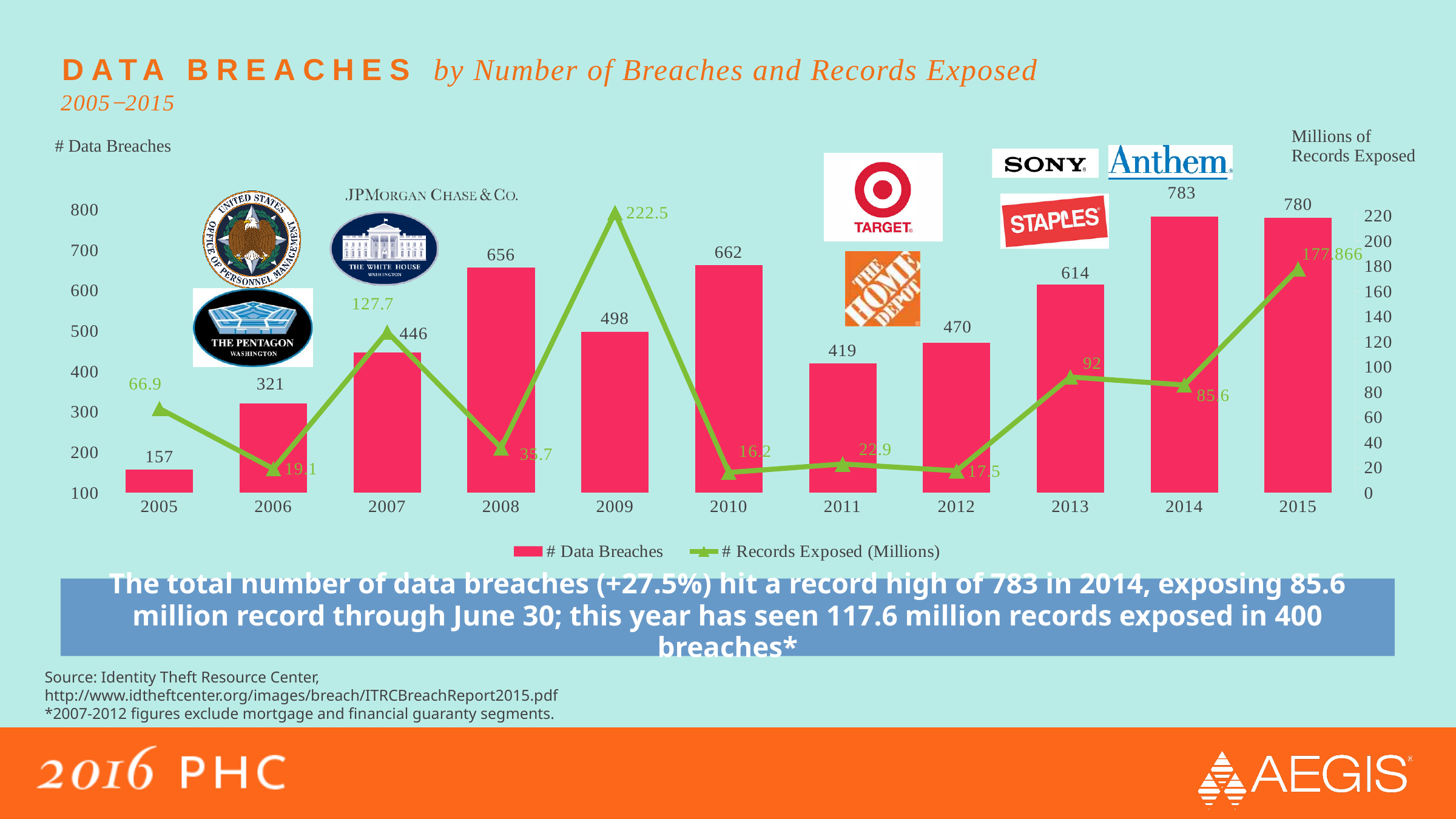
How many years are shown on the x axis? 11 What is the label of the right-hand vertical axis? Millions of Records Exposed What is the difference in the number of data breaches between 2014 and 2013? 169 How many millions of records were exposed in 2009? 222.5 How many series does the legend list? 2 Did the number of data breaches rise or fall from 2012 to 2014? Rise What kind of chart is used to show the number of data breaches? Bar chart Which year had more data breaches, 2010 or 2011? 2010 Which year had the lowest number of data breaches? 2005 Which year had the highest number of data breaches? 2014 Which year had the highest number of records exposed (millions)? 2009 How many data breaches were recorded in 2008? 656